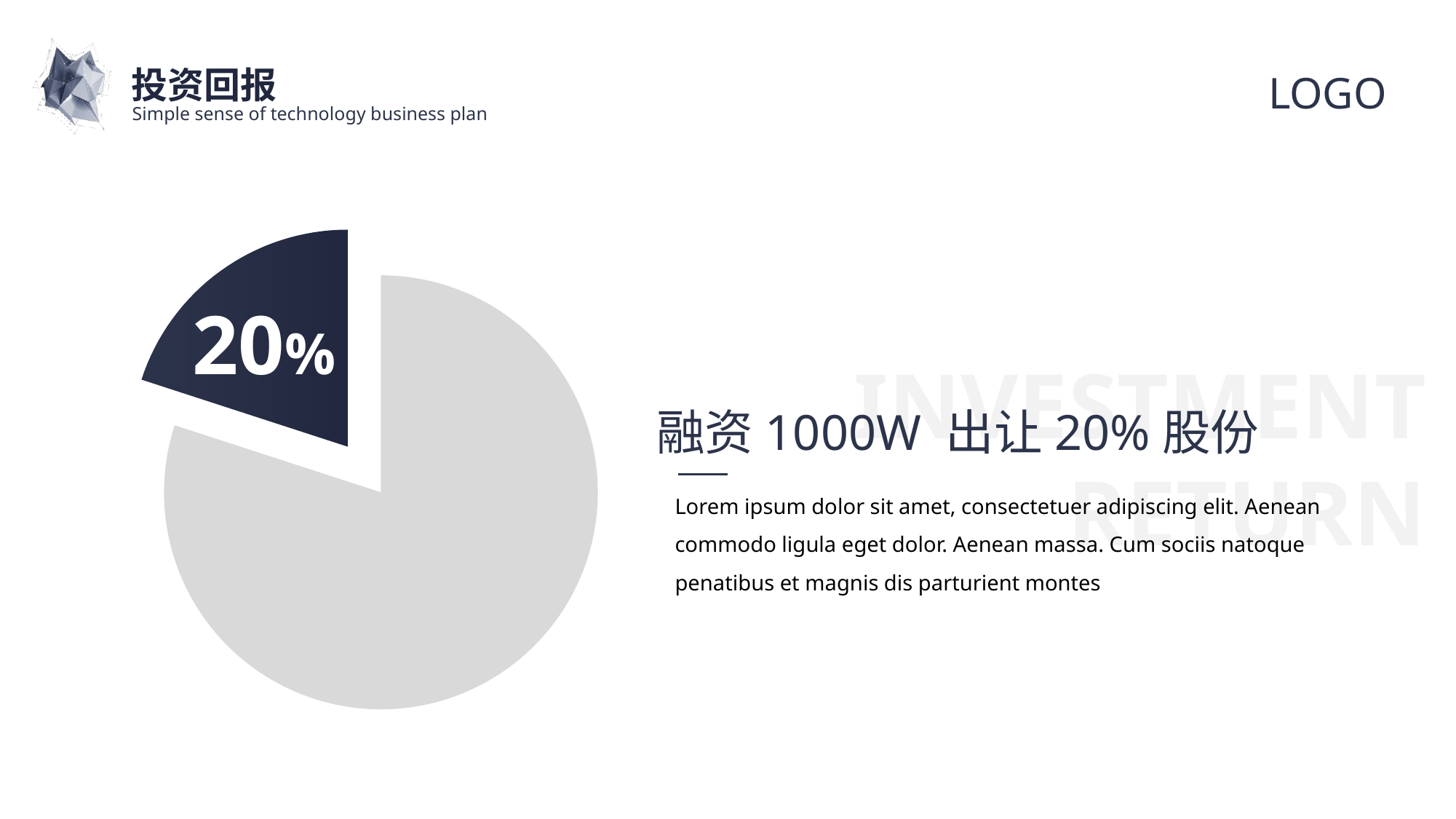
What colour is the slice labelled 20%? dark navy blue Which slice of the pie chart is the smallest? the dark 20% slice Which slice of the pie chart is larger, the dark slice or the grey slice? the grey slice What share of the pie does the dark, separated slice represent? 20% What percentage is printed on the dark slice of the pie chart? 20% Is the share of the dark slice greater or less than 50%? less What kind of chart is shown on the slide? pie chart Which slice of the pie chart is pulled out (exploded) from the rest of the pie? the dark 20% slice How many slices does the pie chart have? 2